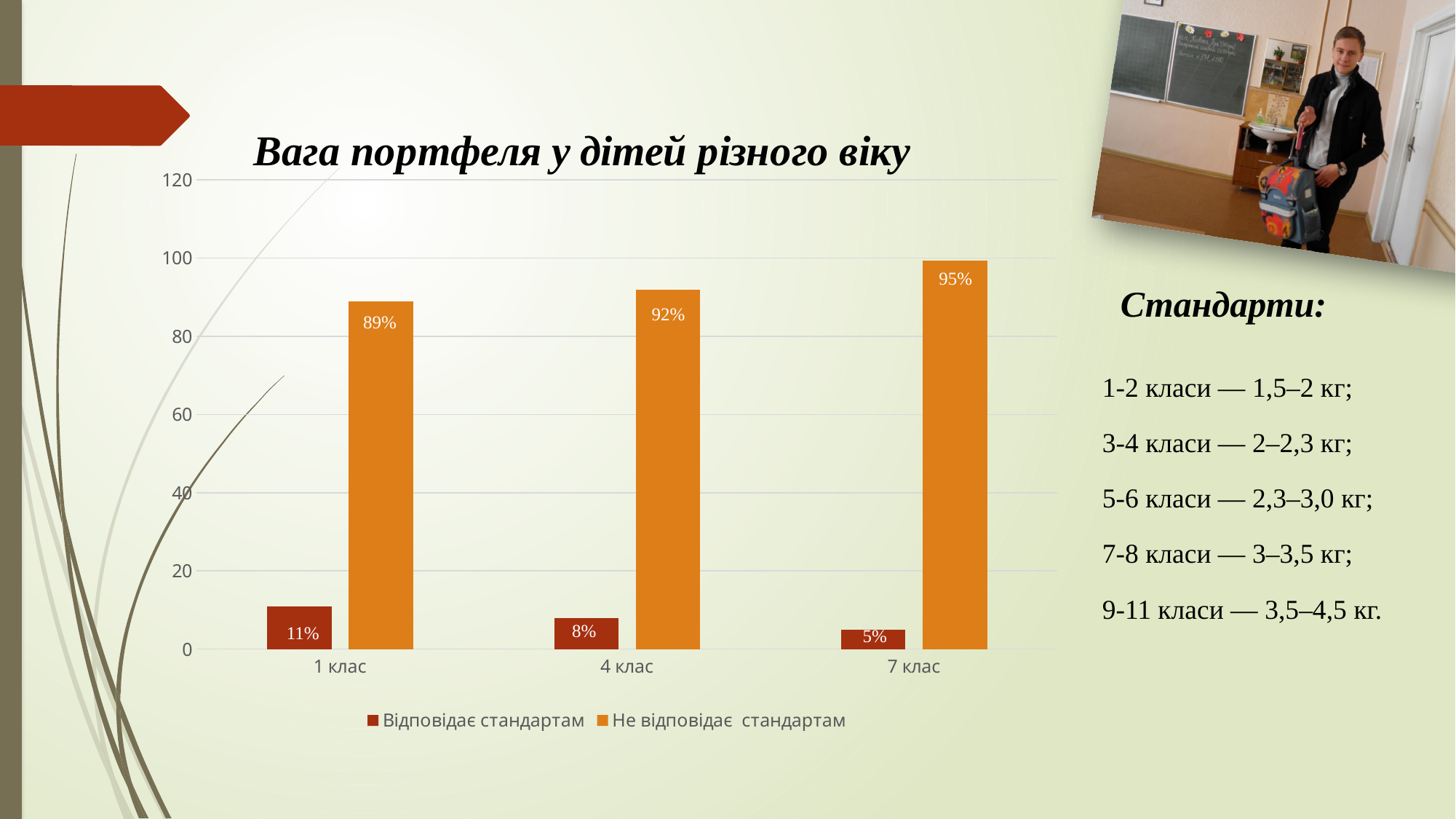
How many categories are shown on the x axis? 3 What is the difference between the "Не відповідає стандартам" values for 7 клас and 1 клас? 6% What kind of chart is shown on the slide? Bar chart What is the title of the chart? Вага портфеля у дітей різного віку Which category has the lowest value for "Відповідає стандартам"? 7 клас Which is larger: the "Відповідає стандартам" value for 1 клас or for 4 клас? 1 клас How many series does the legend list? 2 What is the value for "Не відповідає стандартам" for 4 клас? 92% What is the value for "Не відповідає стандартам" for 1 клас? 89% What is the value for "Відповідає стандартам" for 1 клас? 11% What is the value for "Відповідає стандартам" for 7 клас? 5% Which category has the highest value for "Не відповідає стандартам"? 7 клас